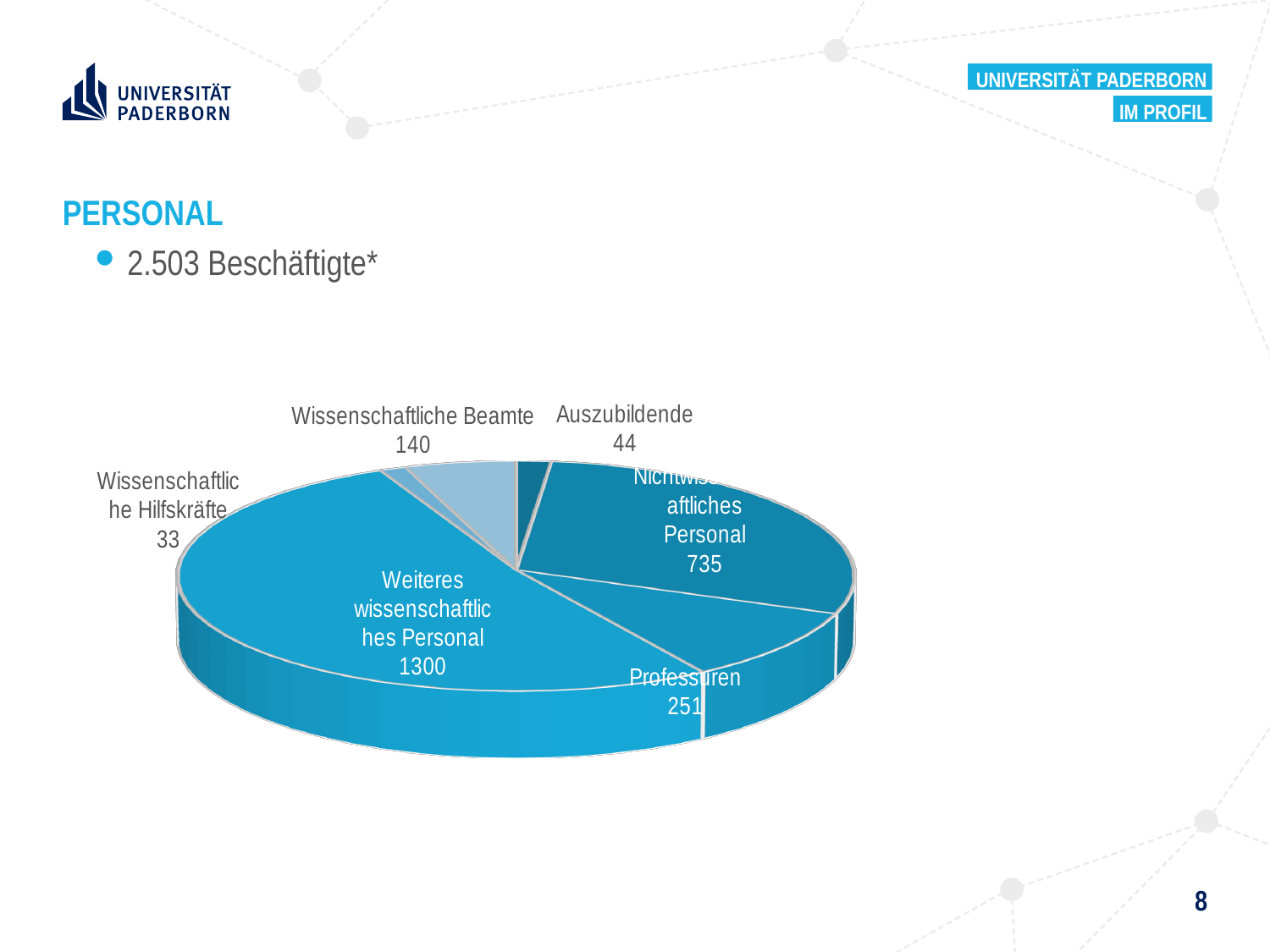
Which category has the smallest slice in the pie chart? Wissenschaftliche Hilfskräfte What is the difference between the values for Nichtwissenschaftliches Personal and Professuren? 484 What is the value for Wissenschaftliche Beamte in the pie chart? 140 Which is larger, the value for Wissenschaftliche Beamte or the value for Auszubildende? Wissenschaftliche Beamte What is the value for Professuren in the pie chart? 251 How many categories (slices) does the pie chart show? 6 Which category has the largest slice in the pie chart? Weiteres wissenschaftliches Personal What is the value for Wissenschaftliche Hilfskräfte in the pie chart? 33 What kind of chart is shown on the slide? Pie chart What is the value for Auszubildende in the pie chart? 44 Does the Weiteres wissenschaftliches Personal slice account for more or less than half of the pie? More What is the value for Weiteres wissenschaftliches Personal in the pie chart? 1300